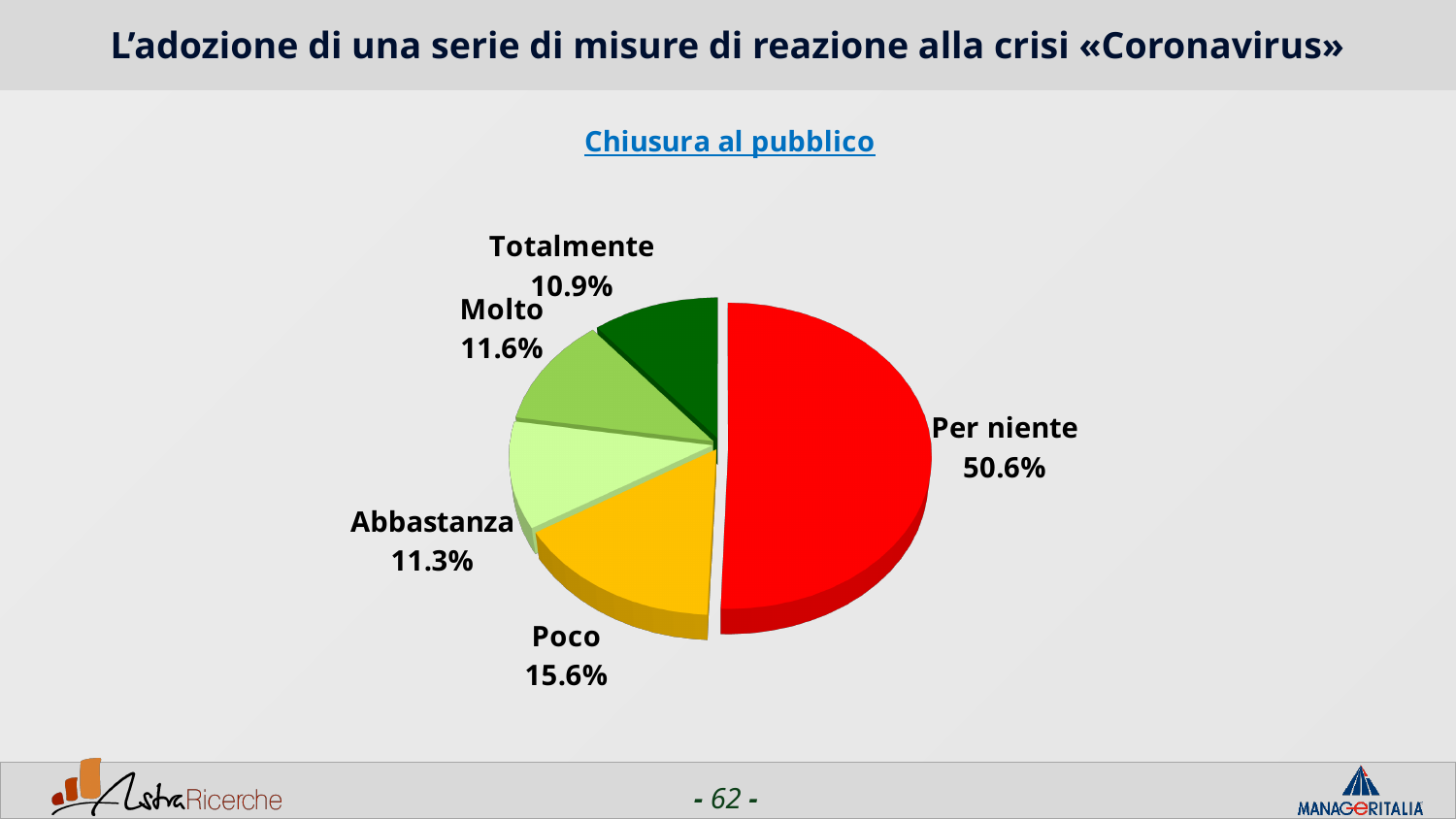
What is the difference between the values for "Molto" and "Totalmente"? 0.7% What is the value shown for "Poco"? 15.6% How many categories are shown in the pie chart? 5 What is the value shown for "Abbastanza"? 11.3% What is the difference between the values for "Per niente" and "Poco"? 35.0% What share of the pie does "Per niente" represent? 50.6% What is the title of the chart? Chiusura al pubblico Which category has the smallest slice of the pie? Totalmente What kind of chart is shown on the slide? Pie chart Which is larger, the value for "Poco" or the value for "Molto"? Poco What is the value shown for "Totalmente"? 10.9% Which category has the largest slice of the pie? Per niente